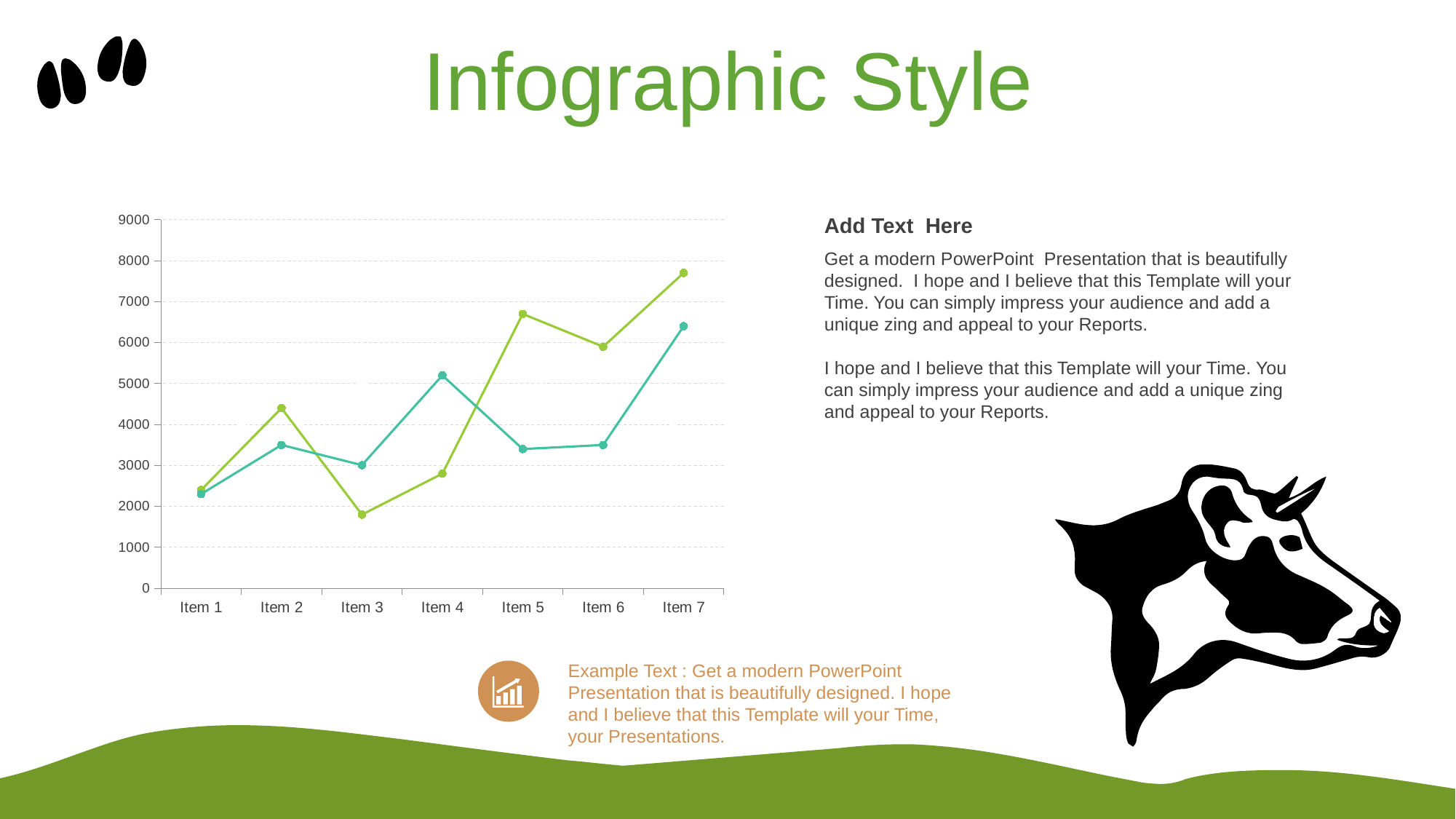
At which item does the light green line reach its highest value? Item 7 At which item does the teal line reach its lowest value? Item 1 Is the value of the light green line at Item 7 greater or less than 7000? greater What kind of chart is shown on the slide? line chart How many categories are shown on the x axis of the chart? 7 Is the value of the teal line at Item 6 greater or less than 4000? less At Item 5, which line has the higher value, the light green line or the teal line? the light green line How many lines are plotted on the chart? 2 At which item does the teal line reach its highest value? Item 7 At which item does the light green line reach its lowest value? Item 3 Does the light green line rise or fall from Item 5 to Item 6? fall Is the value of the light green line at Item 3 greater or less than 2000? less